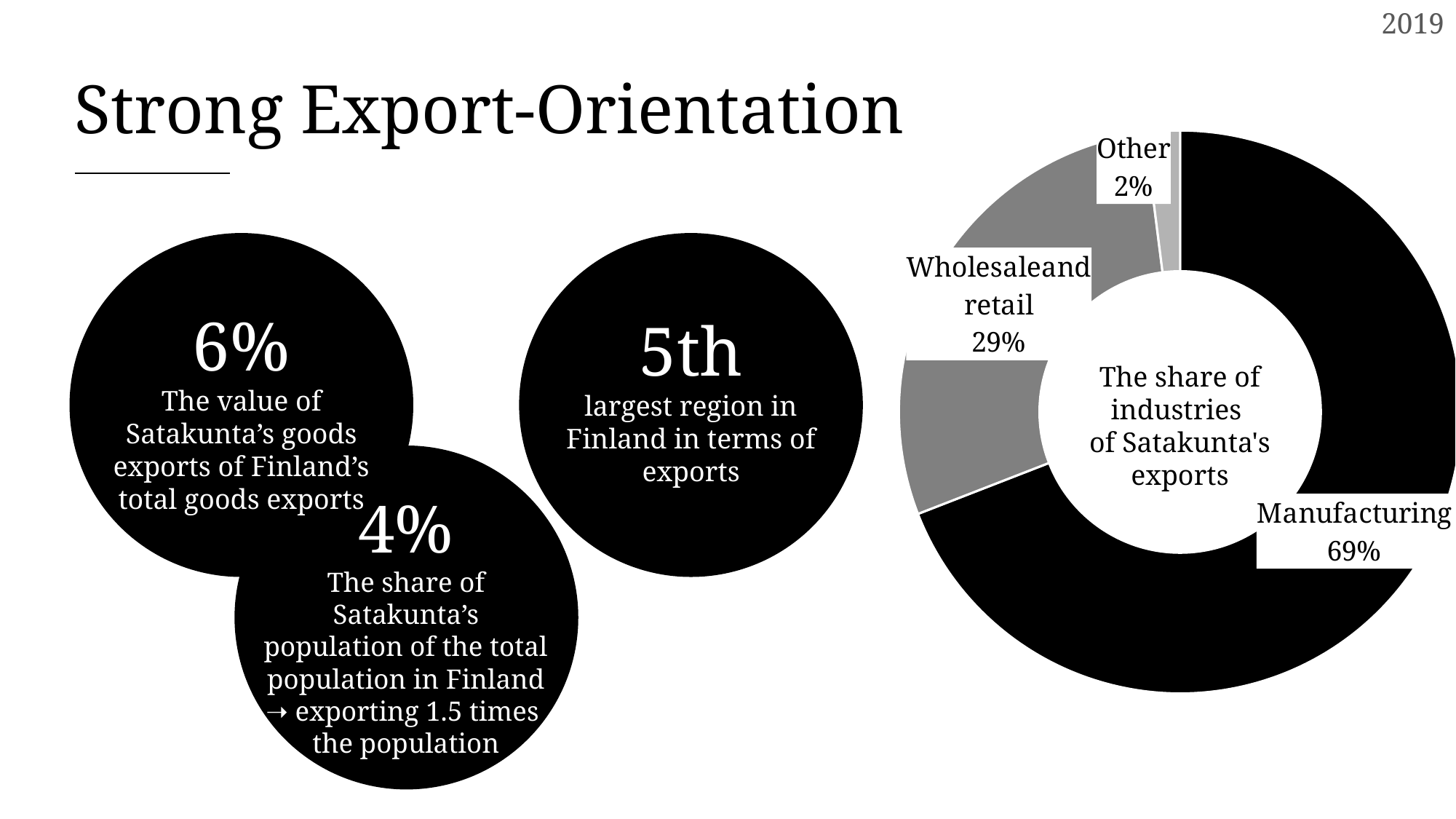
What is the difference in percentage points between the Manufacturing share and the Wholesale and retail share? 40 Which has a larger share of Satakunta's exports, Wholesale and retail or Other? Wholesale and retail What share of Satakunta's exports does Other account for in the doughnut chart? 2% Is the Manufacturing share of Satakunta's exports greater or less than 50%? greater What share of Satakunta's exports does Manufacturing account for in the doughnut chart? 69% Which industry has the smallest share of Satakunta's exports in the chart? Other What is the combined share of Manufacturing and Wholesale and retail in the chart? 98% Which industry has the largest share of Satakunta's exports in the chart? Manufacturing What kind of chart shows the share of industries of Satakunta's exports? Doughnut chart What share of Satakunta's exports does Wholesale and retail account for in the doughnut chart? 29% What is the title shown in the centre of the doughnut chart? The share of industries of Satakunta's exports How many industry categories are shown in the doughnut chart? 3